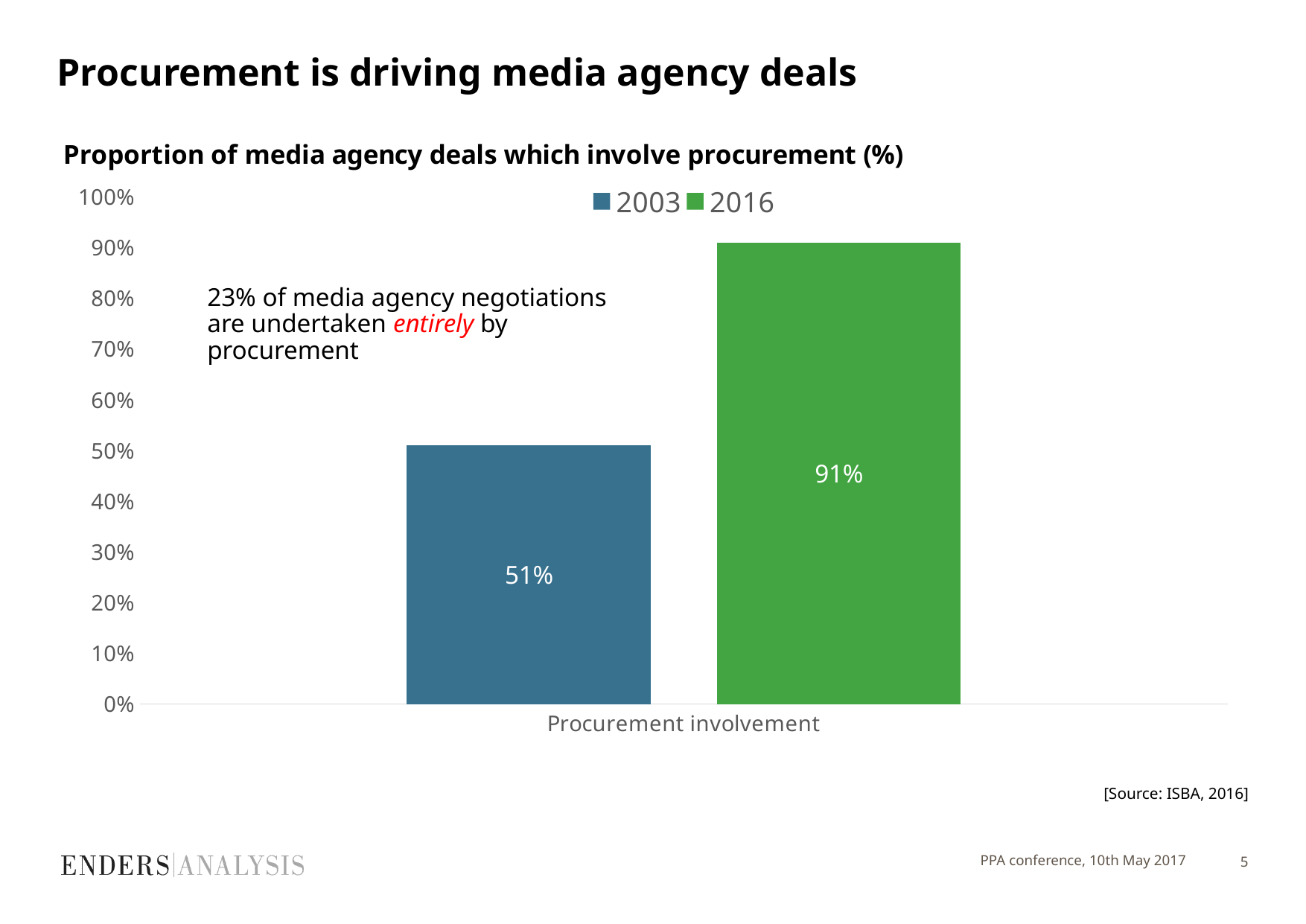
How many series does the legend list? 2 What is the category label on the x axis of the chart? Procurement involvement What is the value for 2003 in the chart? 51% What is the difference between the 2016 value and the 2003 value? 40% What is the value for 2016 in the chart? 91% Which series has the higher value, 2003 or 2016? 2016 What kind of chart is shown on the slide? bar chart Is the value for 2016 greater or less than 80%? greater Which series has the lower value, 2003 or 2016? 2003 Is the value for 2003 larger or smaller than the value for 2016? smaller Is the value for 2003 greater or less than 60%? less What is the title of the chart? Proportion of media agency deals which involve procurement (%)